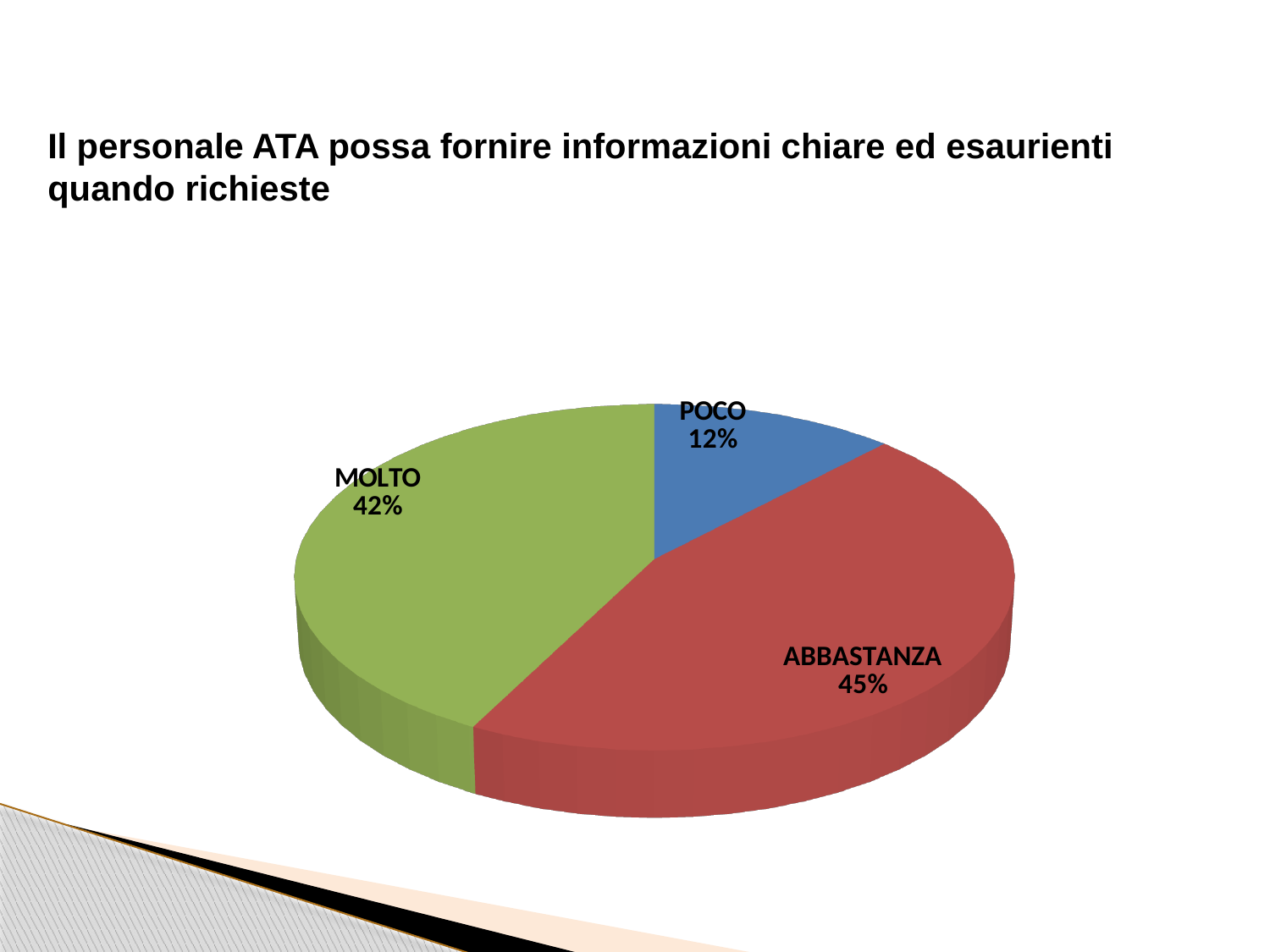
What kind of chart is shown on the slide? pie chart How many slices does the pie chart have? 3 What percentage of the pie is labelled POCO? 12% What percentage of the pie is labelled ABBASTANZA? 45% Which slice of the pie is the smallest? POCO What percentage of the pie is labelled MOLTO? 42% What is the difference in percentage points between the ABBASTANZA and MOLTO slices? 3 Which is larger, the MOLTO slice or the POCO slice? MOLTO Which slice of the pie is the largest? ABBASTANZA What is the difference in percentage points between the MOLTO and POCO slices? 30 What colour is the ABBASTANZA slice? red What colour is the POCO slice? blue